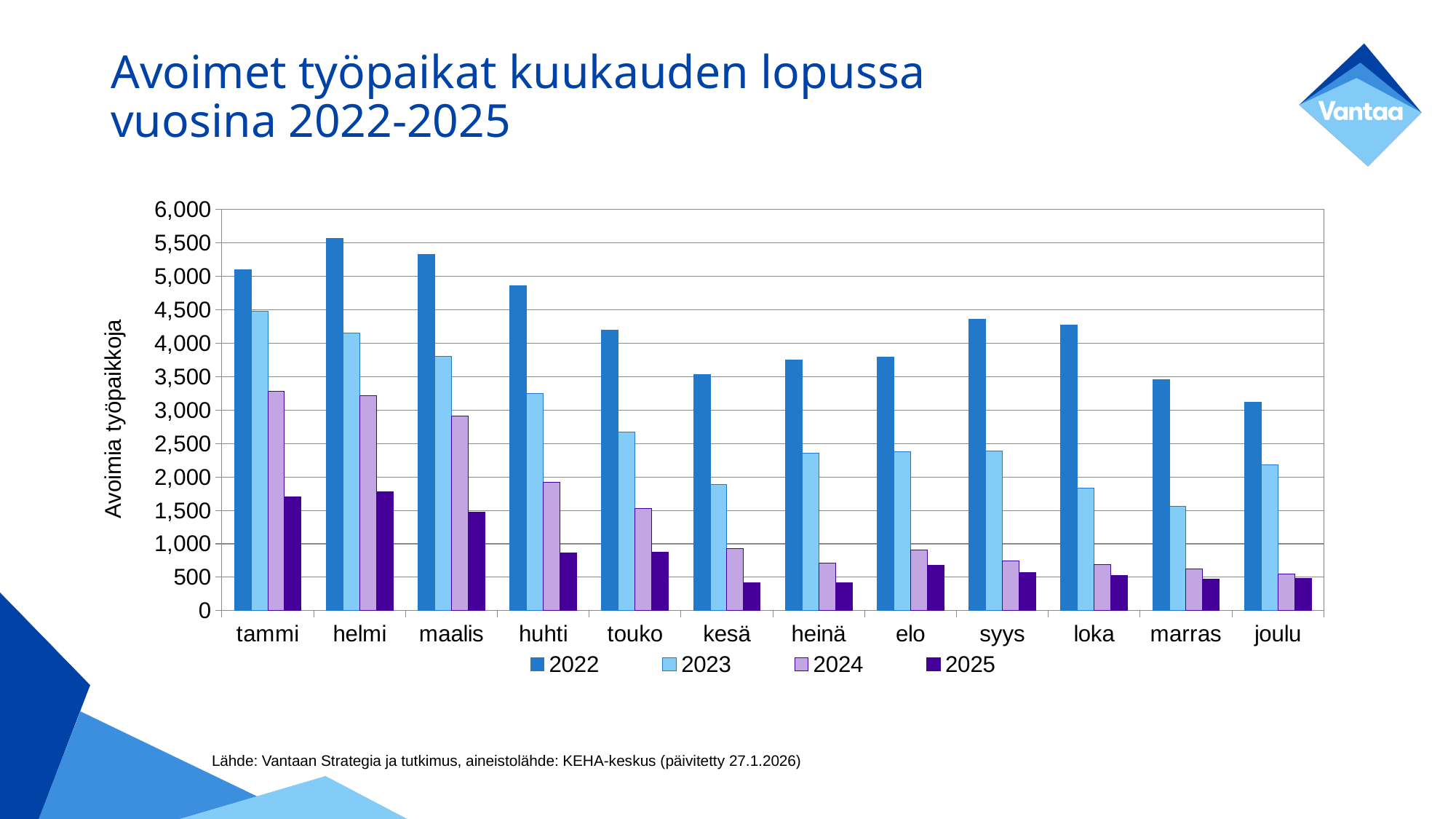
Is the value for 2024 in tammi greater or less than 3,000? greater Which is larger in tammi: the value for 2023 or the value for 2024? 2023 Which month has the lowest value for the 2022 series? joulu What kind of chart is shown on the slide? bar chart How many months are shown on the x axis? 12 Is the value for 2023 in kesä greater or less than 2,000? less Is the value for 2025 in kesä greater or less than 500? less Which month has the highest value for the 2022 series? helmi Which month has the lowest value for the 2023 series? marras What is the label of the y axis? Avoimia työpaikkoja How many series does the legend list? 4